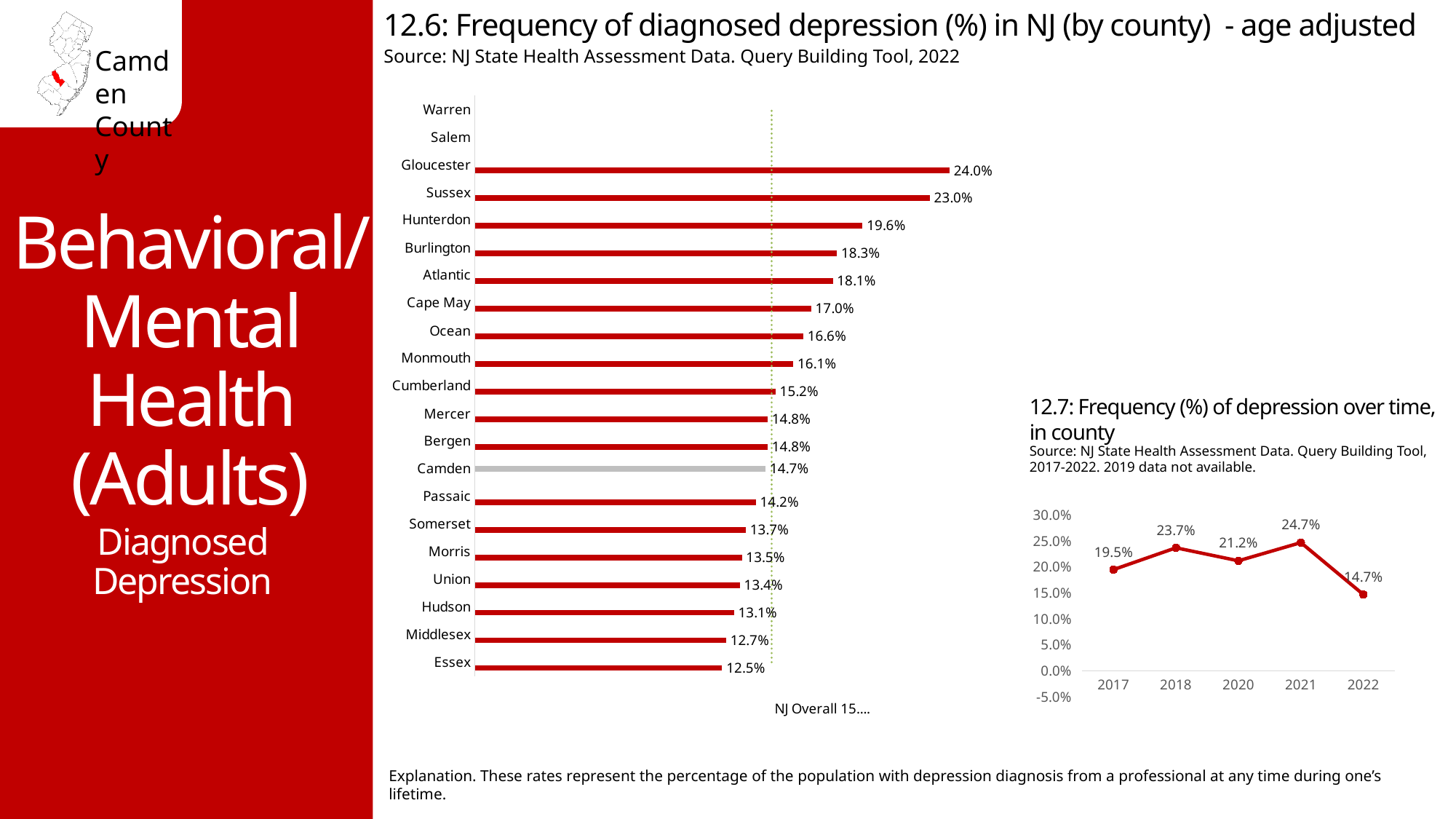
In chart 12.6, what type of chart is used? Bar chart In chart 12.6, which county has a higher value, Burlington or Atlantic? Burlington In chart 12.7, what is the frequency of depression in 2021? 24.7% In chart 12.6, what is the difference between the values for Gloucester and Sussex? 1.0% In chart 12.6, what is the frequency of diagnosed depression for Camden? 14.7% In chart 12.7, which year has the lowest frequency of depression? 2022 In chart 12.6, which county has the highest frequency of diagnosed depression? Gloucester In chart 12.6, which county's bar is shown in grey instead of red? Camden In chart 12.6, which county with a plotted bar has the lowest frequency of diagnosed depression? Essex In chart 12.7, how many years are plotted? 5 In chart 12.6, what is the value shown for Hunterdon? 19.6% In chart 12.7, what is the difference between the 2021 and 2022 values? 10.0%